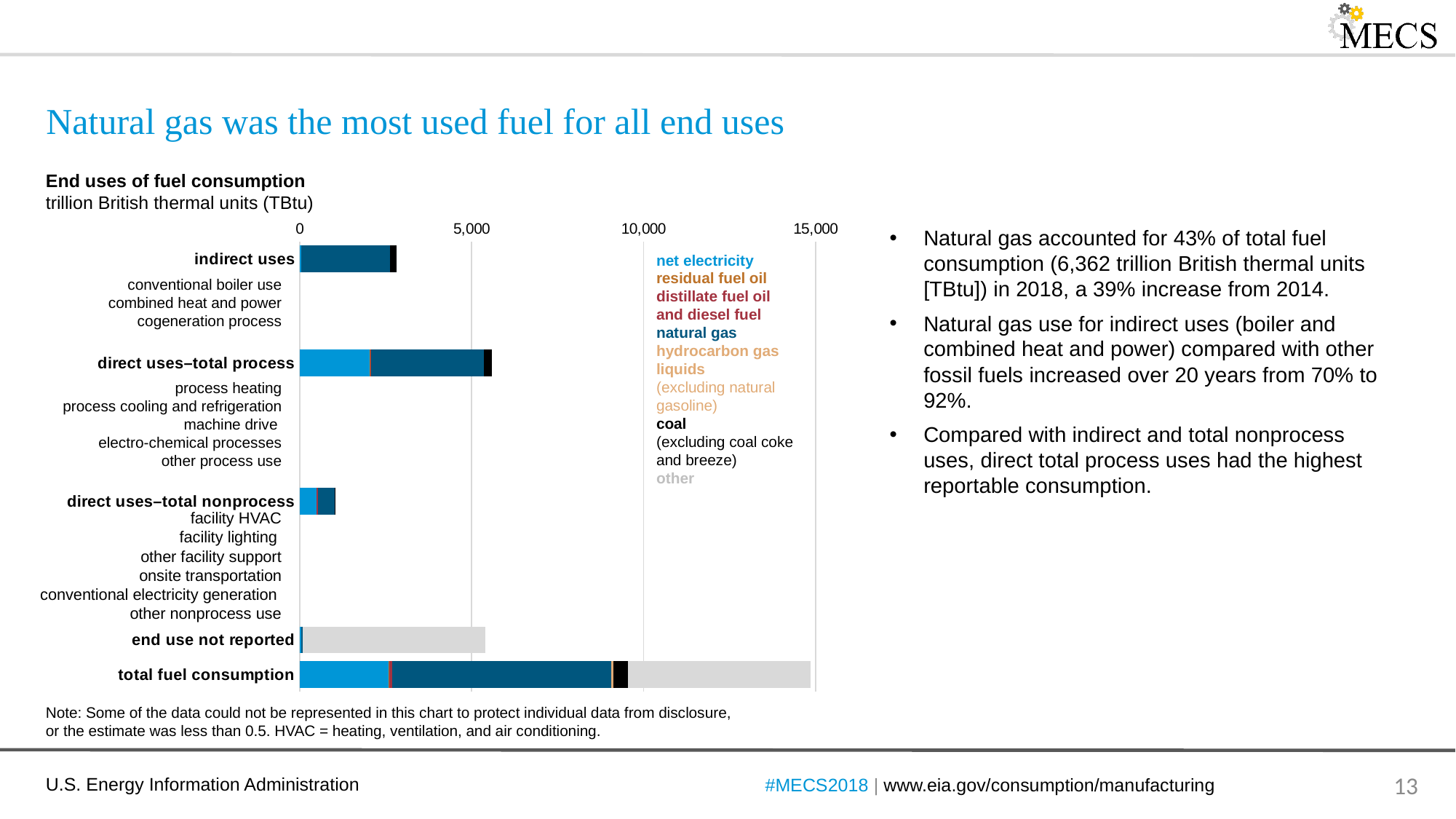
Among indirect uses, direct uses–total process and direct uses–total nonprocess, which has the shortest bar? direct uses–total nonprocess Is the total bar for total fuel consumption greater or less than 10,000? greater Among indirect uses, direct uses–total process and direct uses–total nonprocess, which has the longest bar? direct uses–total process Is the total bar for indirect uses greater or less than 5,000? less Which is larger, the bar for direct uses–total process or the bar for indirect uses? direct uses–total process Which category has the longest bar in the chart? total fuel consumption What is the title of the chart? End uses of fuel consumption What kind of chart is shown on the slide? bar chart In what unit are the values on the chart's axis measured? trillion British thermal units (TBtu) How many fuel series does the chart legend list? 7 Which is larger, the bar for indirect uses or the bar for direct uses–total nonprocess? indirect uses Is the total bar for direct uses–total process greater or less than 5,000? greater